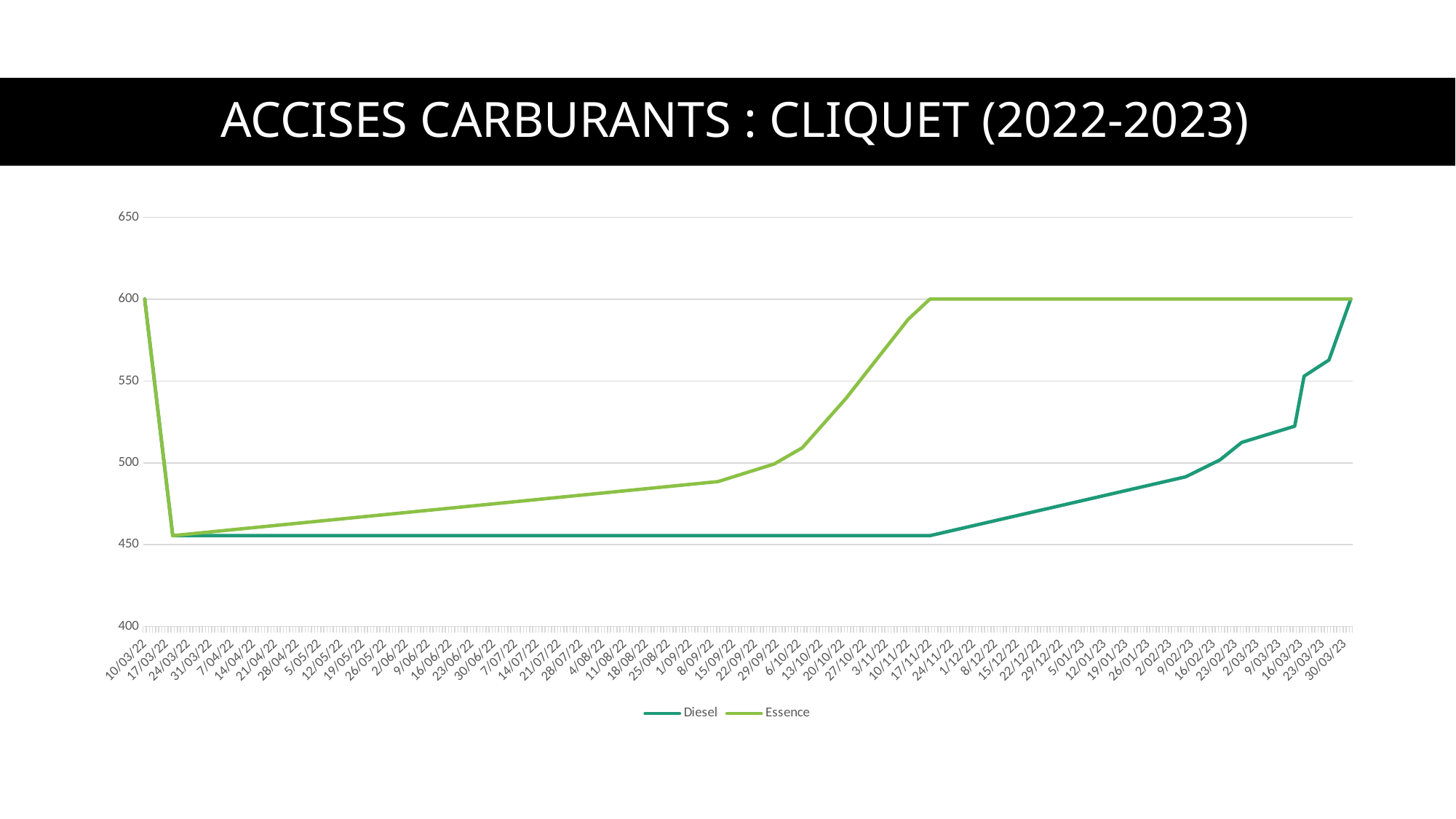
What is the value for Essence on 30/03/23? 600 What kind of chart is shown on the slide? line chart What are the two series named in the legend? Diesel and Essence How many series does the legend list? 2 Is the value for Essence on 6/10/22 greater or less than 500? greater Does the Diesel line rise or fall between 17/11/22 and 30/03/23? rise Does the Essence line rise or fall between 17/03/22 and 17/11/22? rise On 6/10/22, which series has the larger value, Diesel or Essence? Essence Is the value for Diesel on 23/03/23 greater or less than 550? greater Is the value for Diesel on 10/11/22 greater or less than 500? less What is the value for Essence on 10/03/22? 600 What is the title of the slide containing the chart? ACCISES CARBURANTS : CLIQUET (2022-2023)